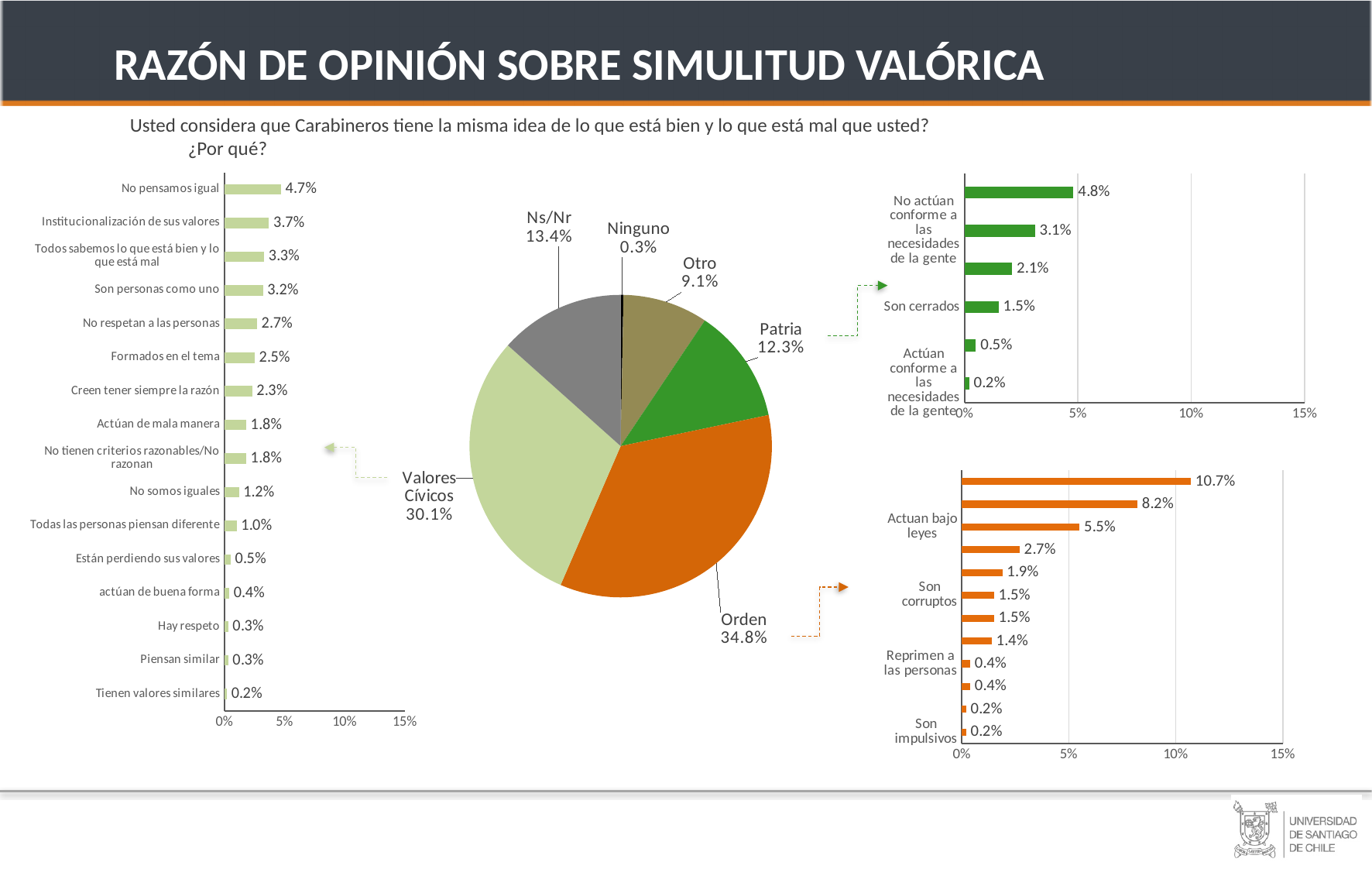
In the pie chart, which slice is the largest? Orden In the pie chart, what is the difference between Valores Cívicos and Patria? 17.8% How many categories does the bar chart on the left of the slide have? 16 In the bar chart on the left of the slide, what is the value for No pensamos igual? 4.7% In the green bar chart at the top right of the slide, what is the value for Son cerrados? 1.5% In the pie chart, which slice is the smallest? Ninguno What kind of chart is the chart in the centre of the slide? pie chart In the pie chart, what share does Orden have? 34.8% In the orange bar chart at the bottom right of the slide, what is the highest value shown? 10.7% In the bar chart on the left of the slide, what is the value for Formados en el tema? 2.5% In the pie chart, which is larger, Ns/Nr or Otro? Ns/Nr How many slices does the pie chart have? 6